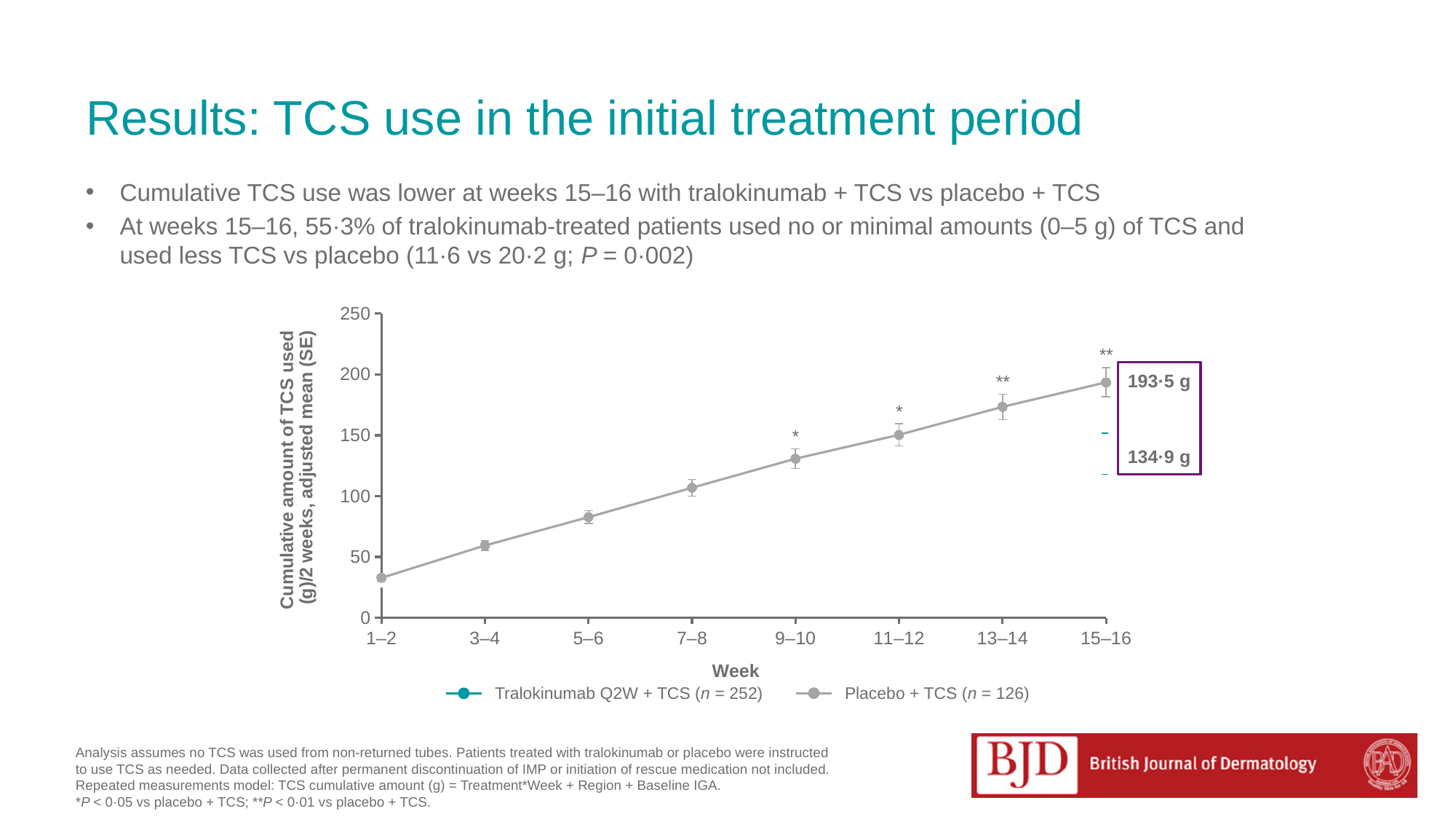
What is the difference between the two values labelled at weeks 15–16 (193·5 g and 134·9 g)? 58·6 g Does the Placebo + TCS line rise or fall from weeks 1–2 to weeks 15–16? Rises What is the lower of the two values labelled at weeks 15–16 on the chart? 134·9 g How many series does the chart legend list? 2 Is the Placebo + TCS value at weeks 7–8 greater or less than 100? greater Is the Placebo + TCS value at weeks 1–2 greater or less than 50? less What is the title of the x axis of the chart? Week At which week interval is the Placebo + TCS cumulative amount highest? 15–16 What type of chart is shown on the slide? Line chart Is the Placebo + TCS value at weeks 13–14 greater or less than 150? greater How many week intervals are shown on the x axis of the chart? 8 What cumulative amount of TCS is labelled for Placebo + TCS at weeks 15–16? 193·5 g